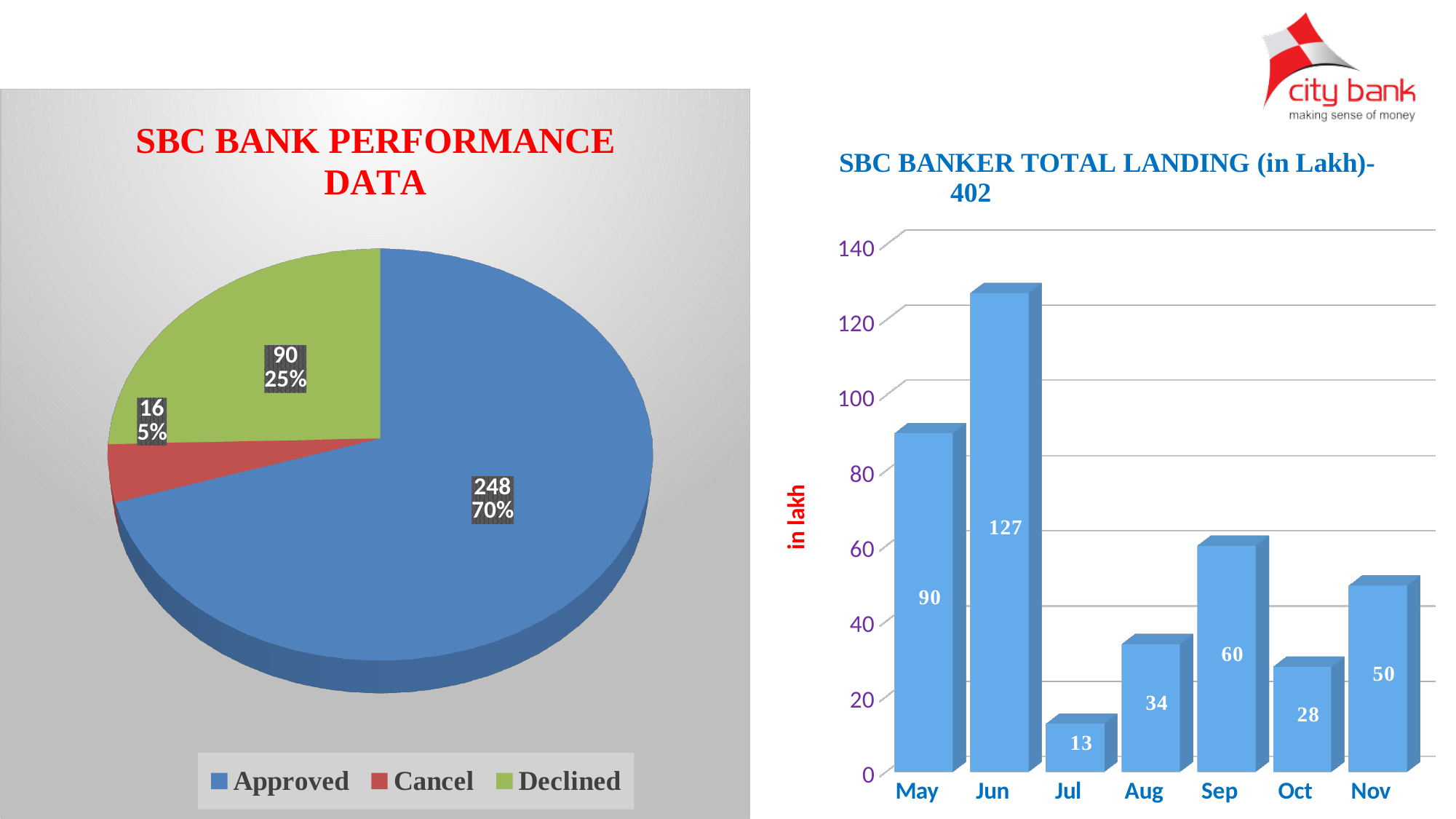
In the SBC BANK PERFORMANCE DATA pie chart, what percentage share does Declined have? 25% In the SBC BANKER TOTAL LANDING bar chart, what is the difference between the values for Jun and May? 37 In the SBC BANK PERFORMANCE DATA pie chart, what colour is the Declined slice? Green In the SBC BANKER TOTAL LANDING bar chart, what is the value for Sep? 60 In the SBC BANK PERFORMANCE DATA pie chart, which category has the smallest slice? Cancel How many months are shown on the x axis of the SBC BANKER TOTAL LANDING bar chart? 7 How many categories does the legend of the SBC BANK PERFORMANCE DATA pie chart list? 3 In the SBC BANKER TOTAL LANDING bar chart, which month has the highest value? Jun In the SBC BANKER TOTAL LANDING bar chart, which is larger, the value for Nov or the value for Aug? Nov In the SBC BANKER TOTAL LANDING bar chart, which month has the lowest value? Jul In the SBC BANK PERFORMANCE DATA pie chart, what value is shown for Approved? 248 What type of chart is the SBC BANK PERFORMANCE DATA chart? Pie chart